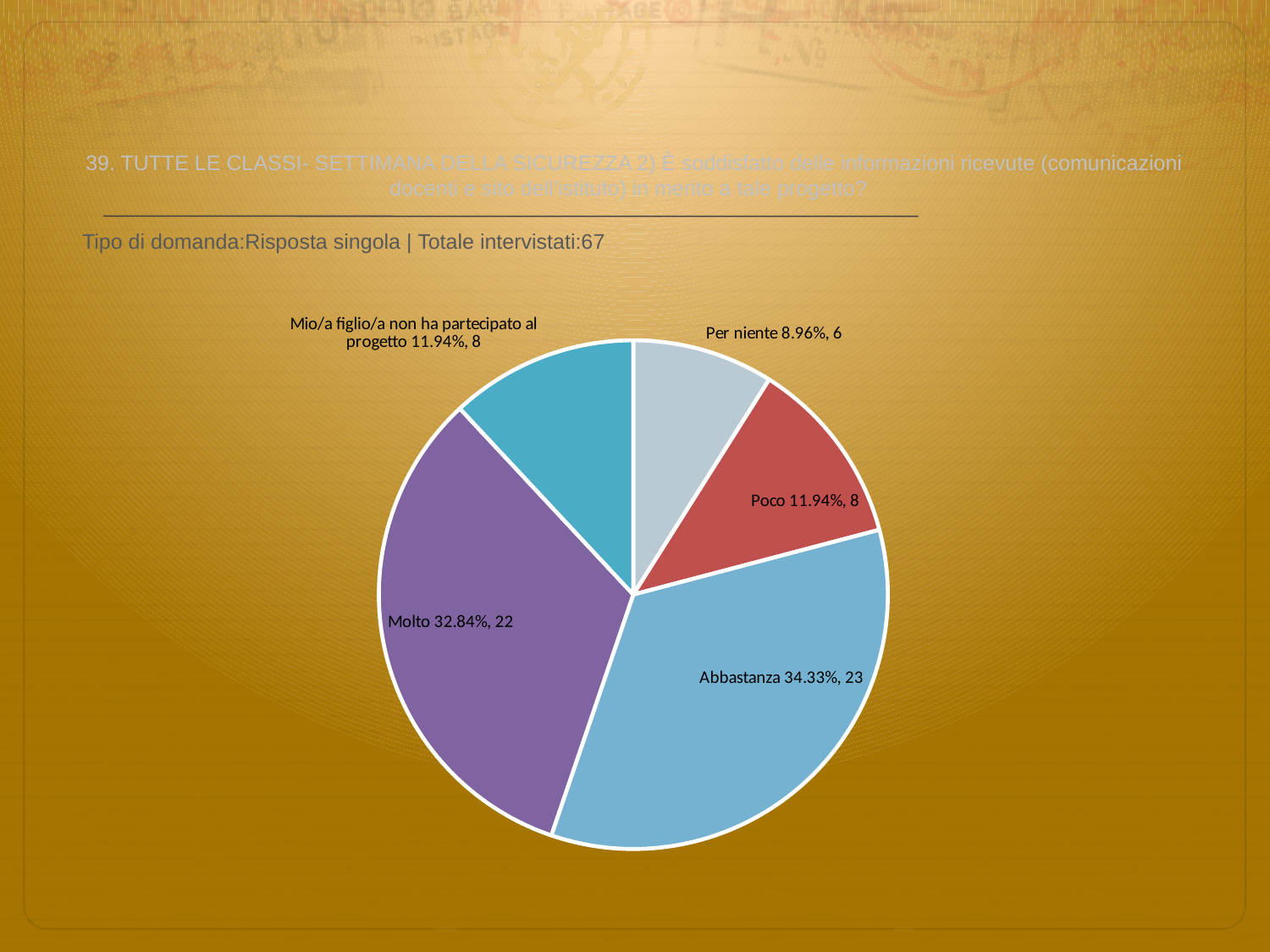
What is the count shown for the 'Per niente' slice? 6 What colour is the 'Molto' slice in the pie chart? Purple Which category has the largest slice in the pie chart? Abbastanza What percentage share does the 'Abbastanza' slice have in the pie chart? 34.33% How many categories are shown in the pie chart? 5 What percentage is shown for the 'Poco' slice? 11.94% What is the total number of respondents (Totale intervistati) stated on the slide? 67 What type of chart is shown on the slide? Pie chart Which has more respondents, 'Poco' or 'Per niente'? Poco What is the difference in respondent count between 'Abbastanza' and 'Molto'? 1 Which category has the smallest slice in the pie chart? Per niente How many respondents chose 'Molto' according to the pie chart? 22